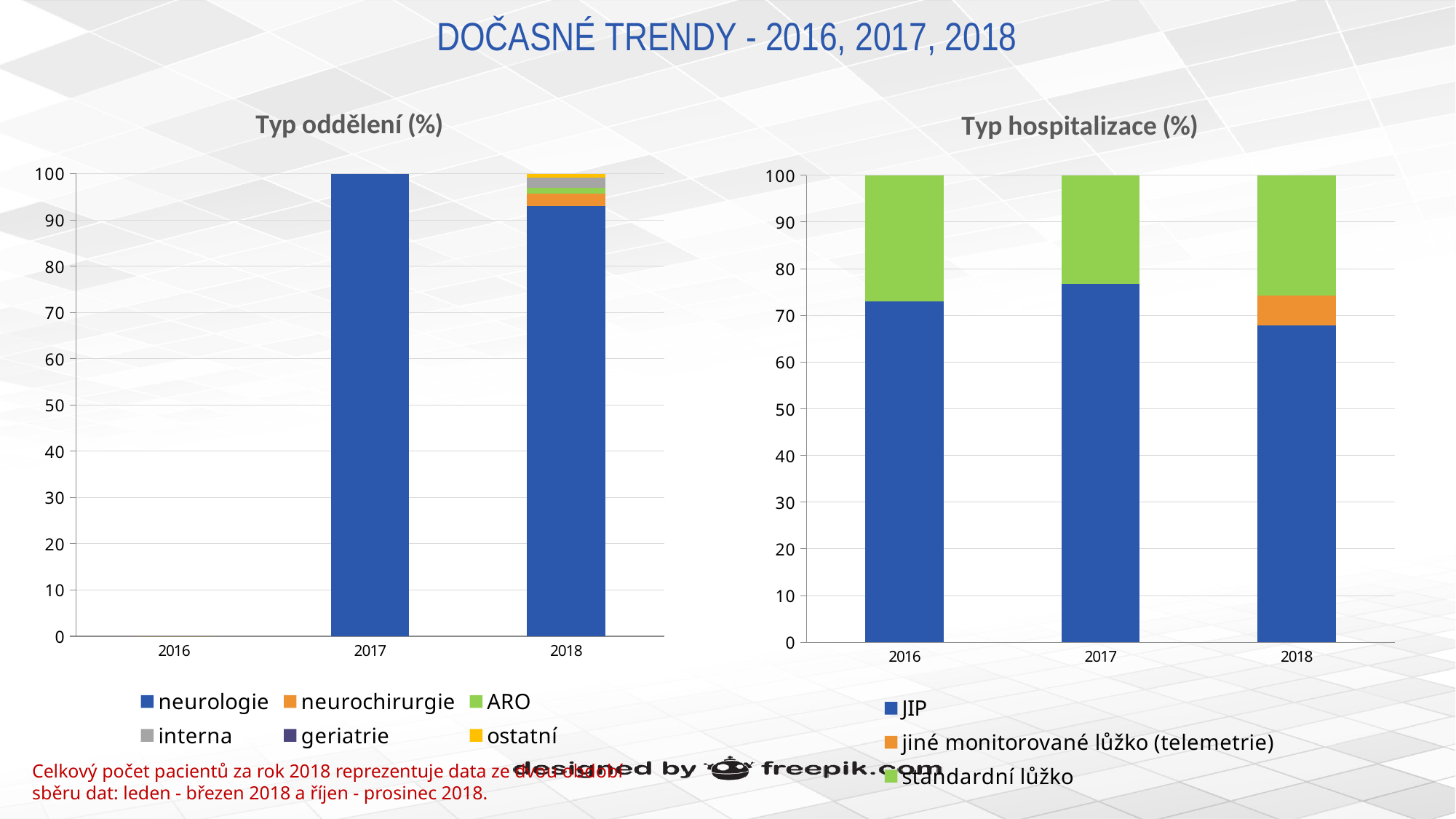
In the 'Typ hospitalizace (%)' chart, is the value for JIP in 2017 greater or less than 70? greater How many years are shown on the x axis of the 'Typ hospitalizace (%)' chart? 3 In the 'Typ hospitalizace (%)' chart, is the JIP value larger in 2017 or in 2018? 2017 In the 'Typ oddělení (%)' chart, is the value for neurologie in 2018 greater or less than 90? greater In the 'Typ hospitalizace (%)' chart, which year has the lowest JIP value? 2018 In the 'Typ hospitalizace (%)' chart, which year has the highest JIP value? 2017 How many series does the legend of the 'Typ hospitalizace (%)' chart list? 3 How many series does the legend of the 'Typ oddělení (%)' chart list? 6 In the 'Typ oddělení (%)' chart, what is the value for neurologie in 2017? 100 In the 'Typ hospitalizace (%)' chart, in which year does the 'jiné monitorované lůžko (telemetrie)' segment appear? 2018 In the 'Typ hospitalizace (%)' chart, is the value for JIP in 2018 greater or less than 70? less What kind of chart is the 'Typ oddělení (%)' chart? stacked bar chart